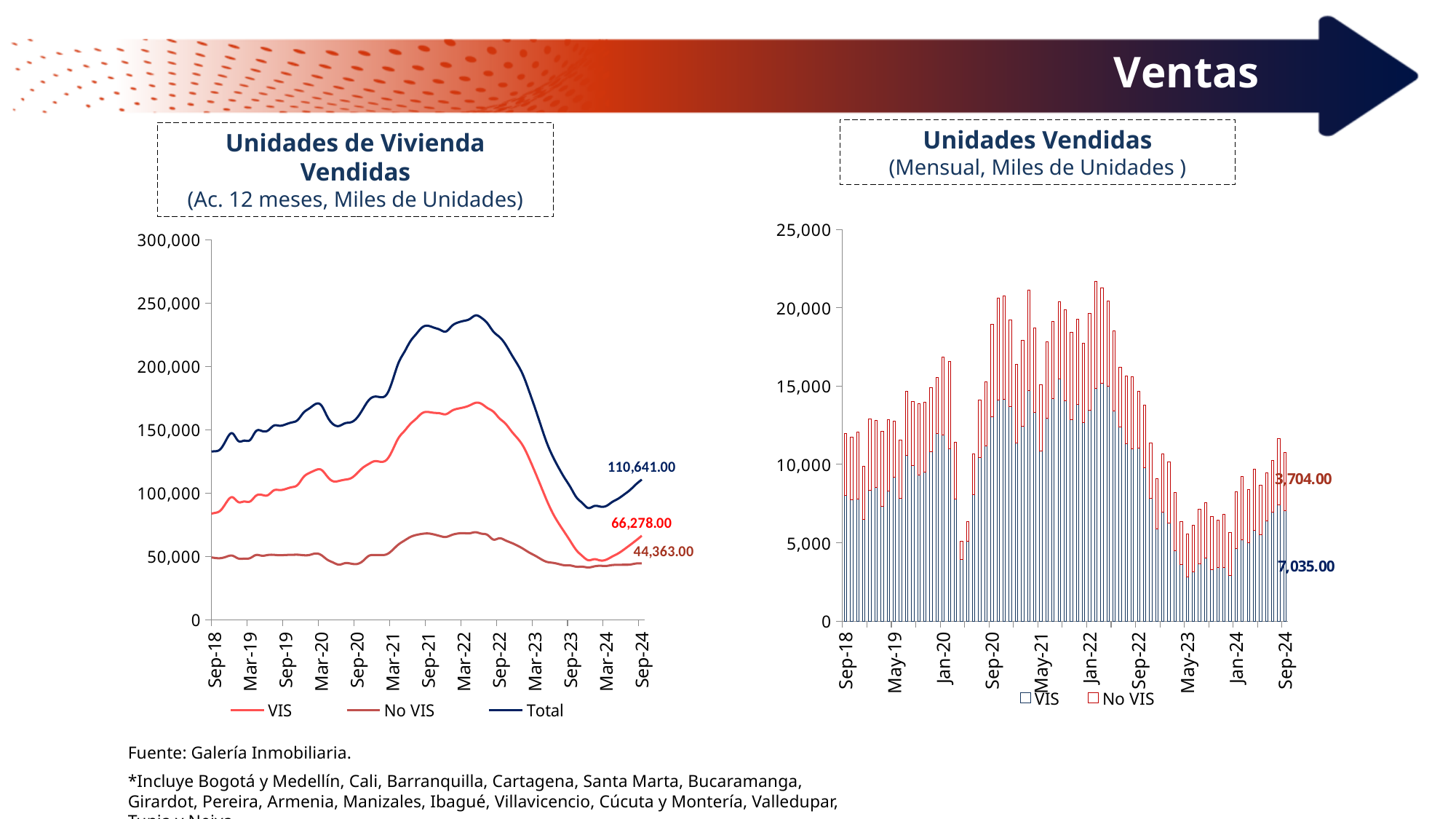
In the left chart 'Unidades de Vivienda Vendidas', what is the difference between the VIS and No VIS values at Sep-24? 21,915.00 What kind of chart is the right chart, 'Unidades Vendidas (Mensual)'? bar chart In the left chart 'Unidades de Vivienda Vendidas', what is the value of the No VIS series at Sep-24? 44,363.00 In the right chart 'Unidades Vendidas (Mensual)', what is the No VIS value at Sep-24? 3,704.00 In the right chart 'Unidades Vendidas (Mensual)', what is the total of the stacked bar at Sep-24 (VIS plus No VIS)? 10,739.00 In the left chart 'Unidades de Vivienda Vendidas', is the Total value at Mar-22 greater or less than 200,000? greater How many series does the legend of the right chart 'Unidades Vendidas (Mensual)' list? 2 In the left chart 'Unidades de Vivienda Vendidas', what is the value of the VIS series at Sep-24? 66,278.00 In the right chart 'Unidades Vendidas (Mensual)', what is the VIS value at Sep-24? 7,035.00 How many series does the legend of the left chart 'Unidades de Vivienda Vendidas' list? 3 What kind of chart is the left chart, 'Unidades de Vivienda Vendidas'? line chart In the left chart 'Unidades de Vivienda Vendidas', what is the value of the Total series at Sep-24? 110,641.00